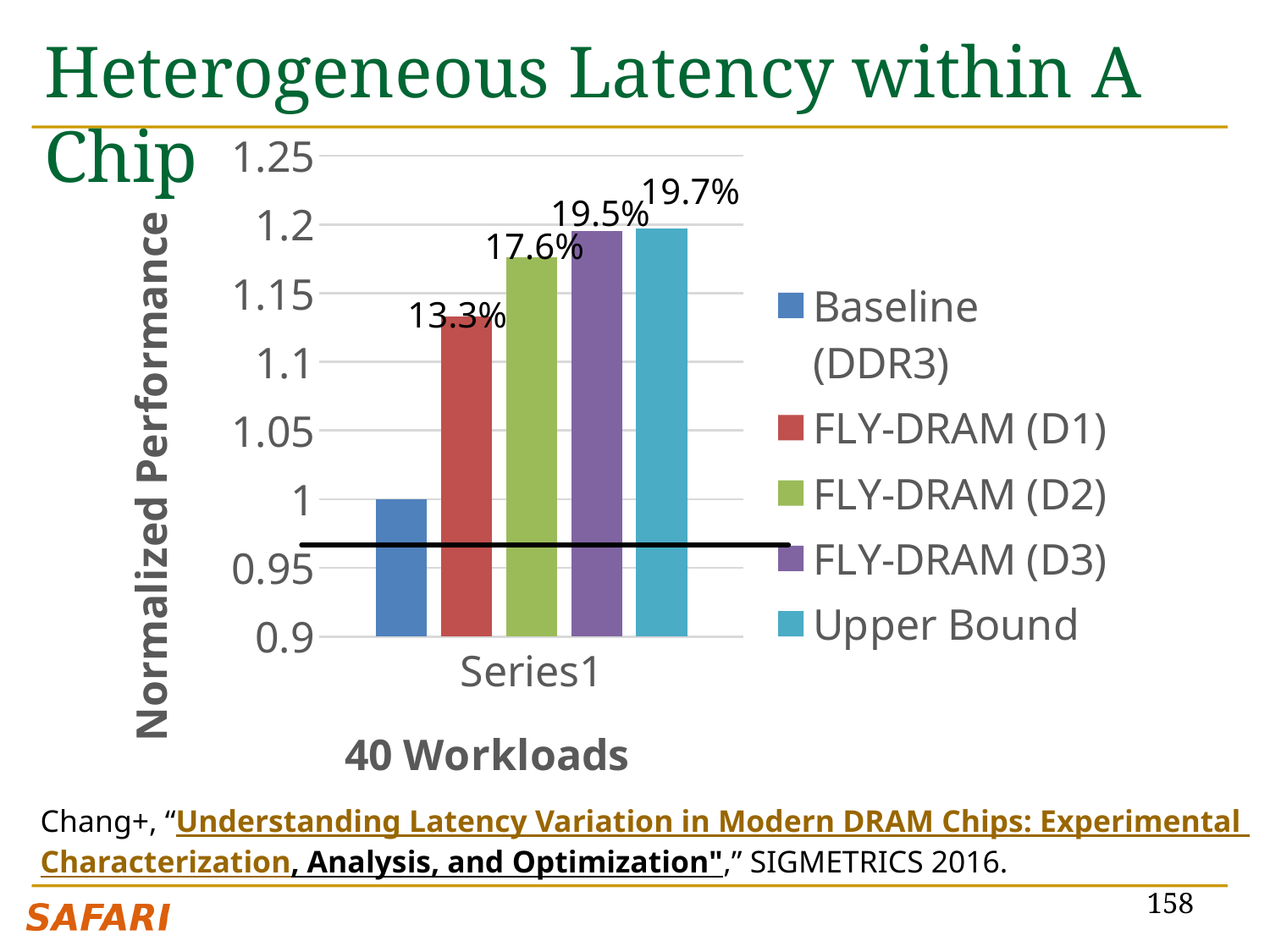
What is the difference between the Upper Bound label and the FLY-DRAM (D1) label? 6.4% What is the data label shown on the FLY-DRAM (D1) bar? 13.3% What is the data label shown on the Upper Bound bar? 19.7% What is the data label shown on the FLY-DRAM (D3) bar? 19.5% Is the value for FLY-DRAM (D1) greater or less than 1.1? greater Which series has the shortest bar? Baseline (DDR3) How many series does the legend list? 5 What is the data label shown on the FLY-DRAM (D2) bar? 17.6% What normalized performance value does the Baseline (DDR3) bar reach? 1 What is the title of the vertical axis? Normalized Performance Which bar is taller, FLY-DRAM (D1) or FLY-DRAM (D2)? FLY-DRAM (D2) Which series has the tallest bar? Upper Bound